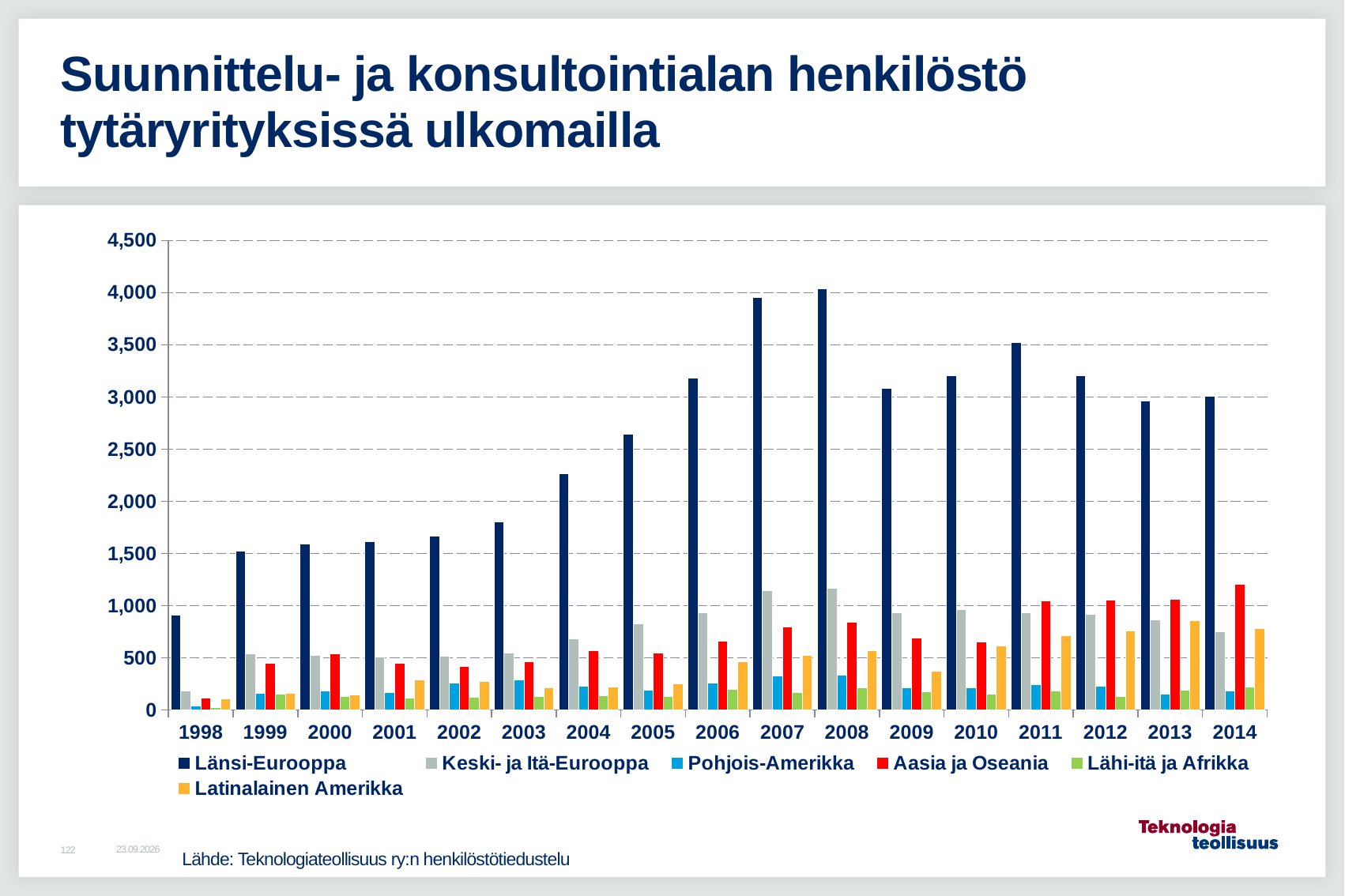
Is the value for Länsi-Eurooppa in 2005 greater or less than 2,500? greater Does the value for Länsi-Eurooppa rise or fall from 1998 to 2008? rise How many series does the legend list? 6 In which year is the value for Länsi-Eurooppa highest? 2008 Is the value for Länsi-Eurooppa in 1998 greater or less than 1,000? less What kind of chart is shown on the slide? bar chart Is the value for Aasia ja Oseania in 2014 greater or less than 1,000? greater In 2007, which is larger: Keski- ja Itä-Eurooppa or Aasia ja Oseania? Keski- ja Itä-Eurooppa In 2014, which is larger: Aasia ja Oseania or Keski- ja Itä-Eurooppa? Aasia ja Oseania In which year is the value for Länsi-Eurooppa lowest? 1998 How many years are shown on the x axis? 17